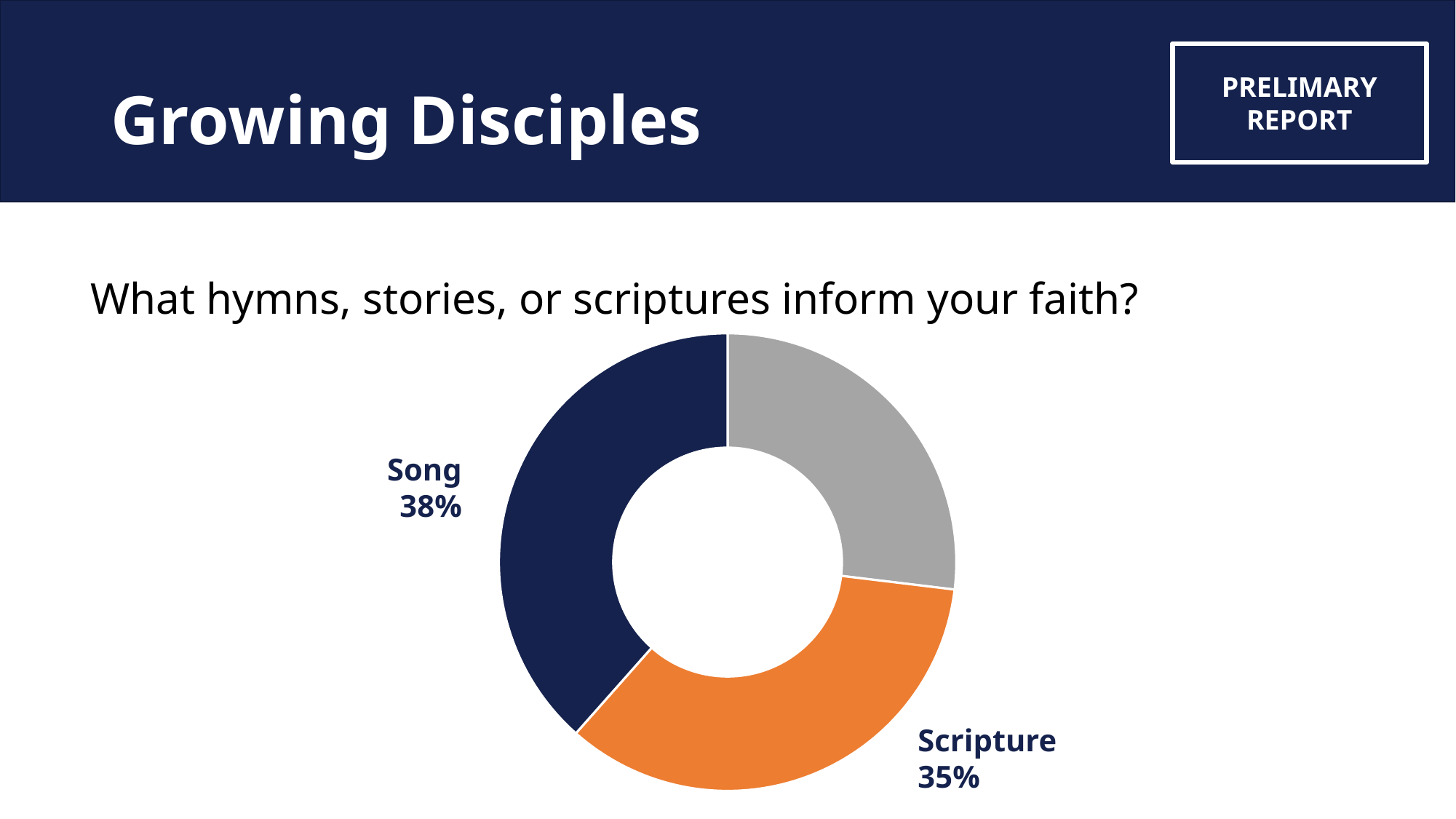
What is the difference in percentage points between Song and Scripture? 3 percentage points What question does the chart on the slide answer? What hymns, stories, or scriptures inform your faith? Which is larger, the share for Song or the share for Scripture? Song What colour is the Scripture slice in the doughnut chart? Orange How many slices does the doughnut chart have? 3 What percentage is shown for Scripture in the doughnut chart? 35% What percentage is shown for Song in the doughnut chart? 38% What kind of chart is shown on the slide? Doughnut (pie) chart Which labelled category has the largest share of the doughnut chart? Song